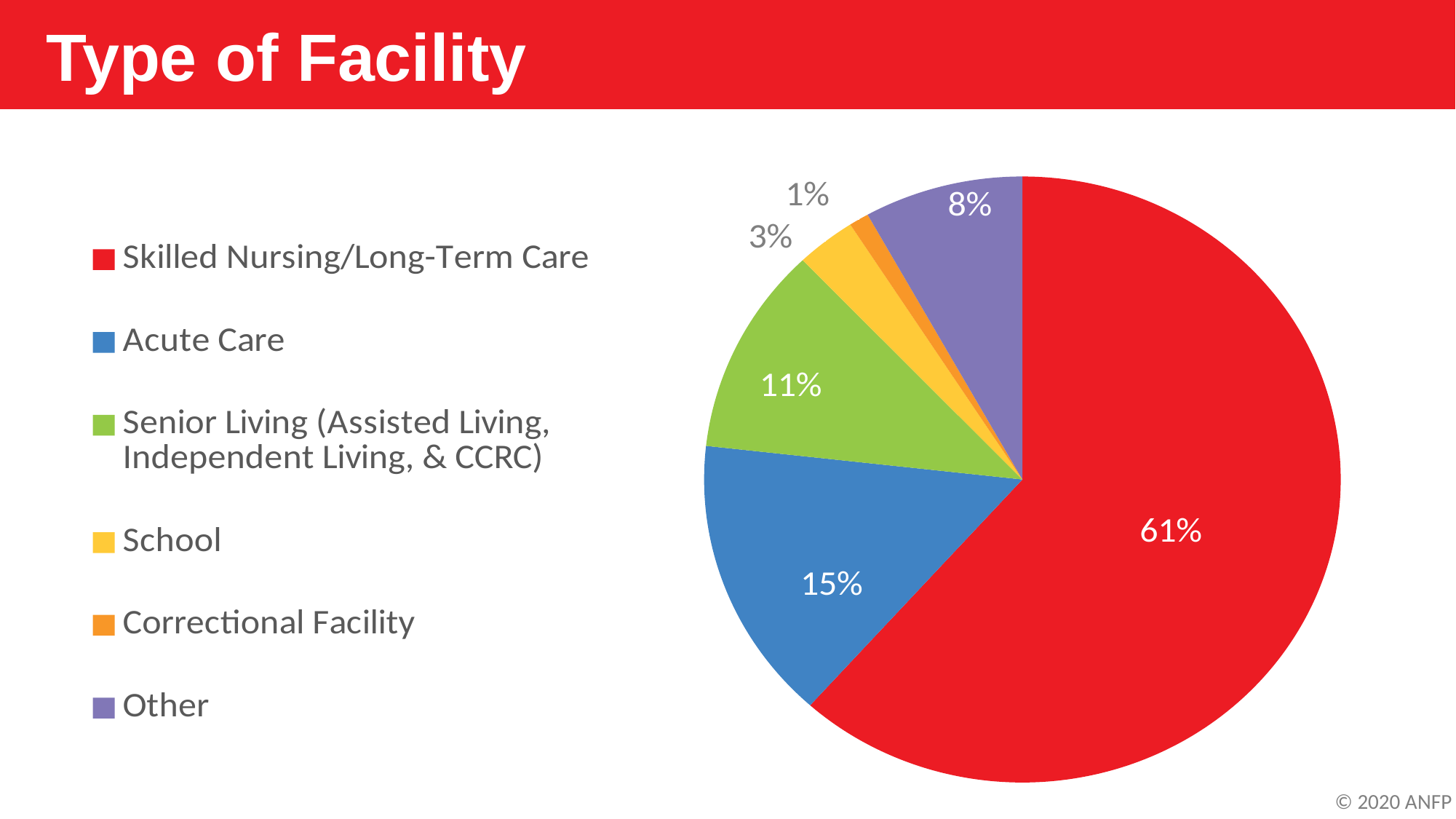
What percentage of the pie is Skilled Nursing/Long-Term Care? 61% Which is larger, the share for Other or the share for School? Other Which facility type has the smallest share of the pie? Correctional Facility How many categories does the legend list? 6 What is the difference in percentage points between Skilled Nursing/Long-Term Care and Acute Care? 46 What percentage of the pie is Acute Care? 15% What percentage of the pie is Other? 8% Which facility type has the largest share of the pie? Skilled Nursing/Long-Term Care What percentage of the pie is Correctional Facility? 1% What percentage of the pie is Senior Living (Assisted Living, Independent Living, & CCRC)? 11% What percentage of the pie is School? 3% What type of chart is shown on the slide? Pie chart